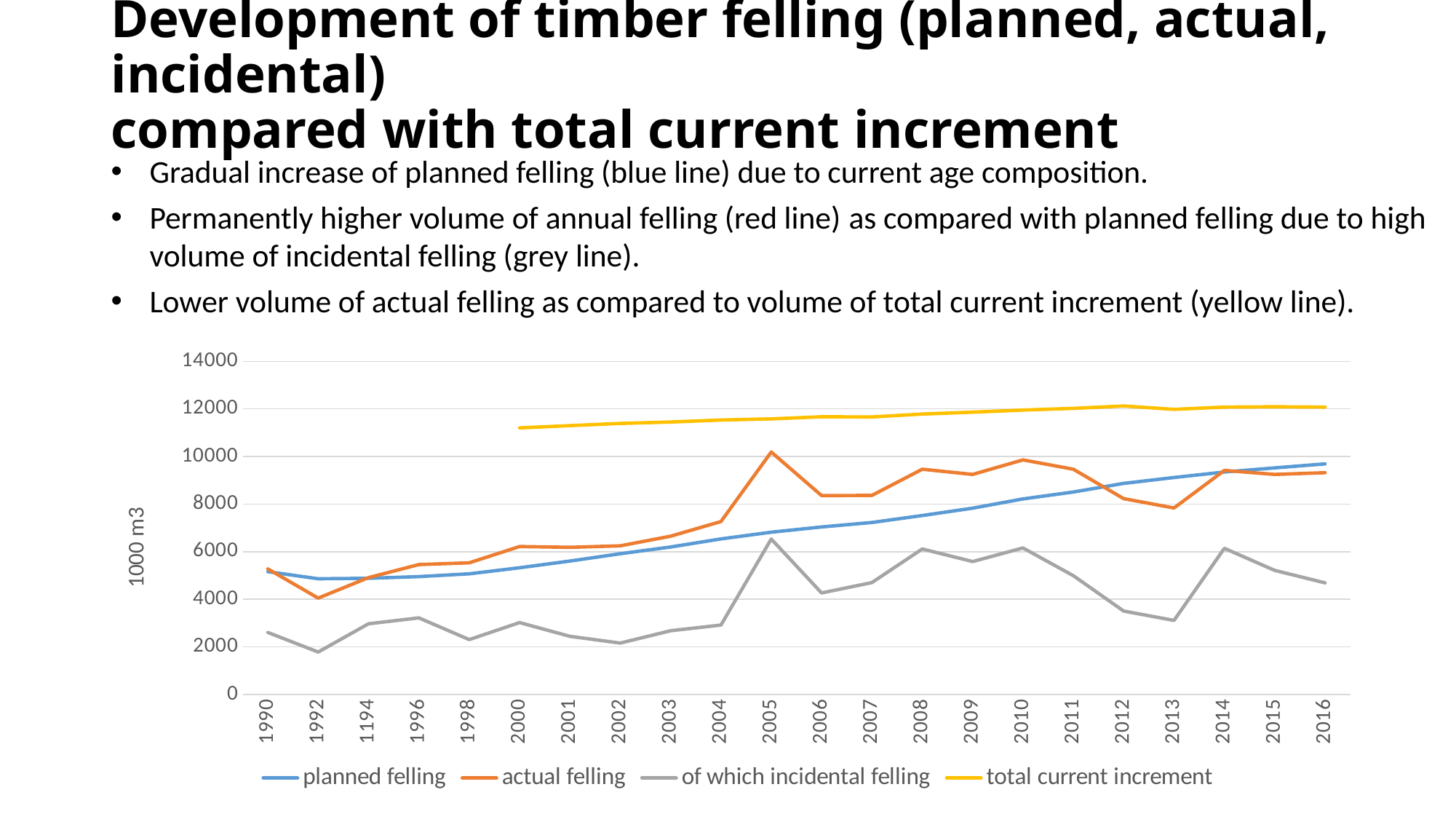
How many series does the legend list? 4 In which year does the actual felling line reach its highest value? 2005 Is the value for total current increment in 2000 greater or less than 10000? greater Is the value for planned felling in 2016 greater or less than 8000? greater What is the label on the vertical axis? 1000 m3 Does the planned felling line rise or fall from 1990 to 2016? rise In 2005, which is larger: actual felling or planned felling? actual felling Is the value for 'of which incidental felling' in 1992 greater or less than 2000? less What kind of chart is shown on the slide? line chart In which year is the 'of which incidental felling' line at its lowest? 1992 How many years are shown on the x axis? 22